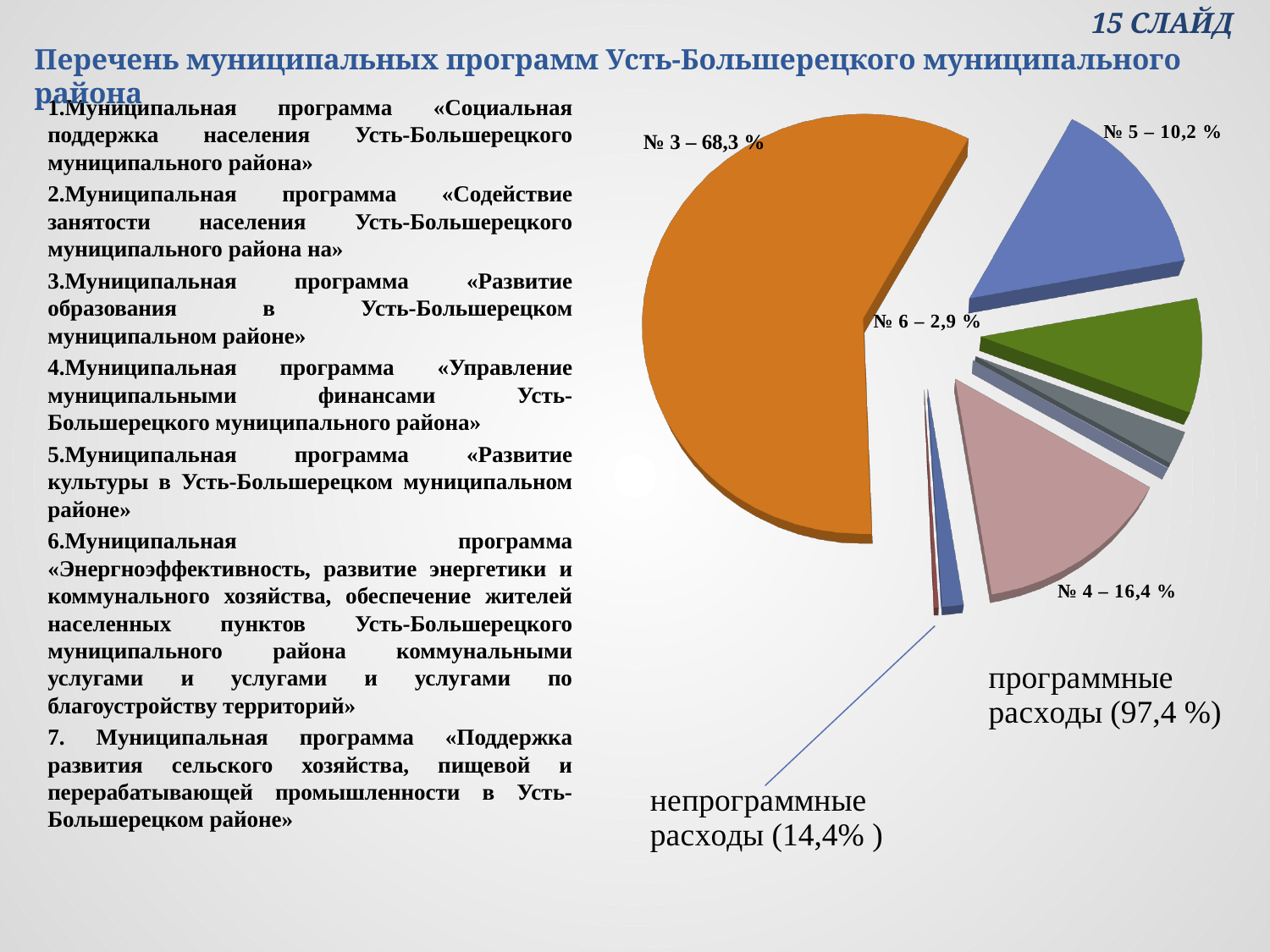
What colour is the largest slice of the pie chart? orange What share is labelled for programme № 4 in the pie chart? 16,4 % What kind of chart is shown on the slide? pie chart Which labelled programme has the smallest share in the pie chart? № 6 Which has the larger share, № 5 or № 4? № 4 What share is labelled for programme № 3 in the pie chart? 68,3 % By how many percentage points does the share of № 3 exceed the share of № 4? 51,9 % Which labelled programme has the largest share in the pie chart? № 3 What percentage is given for programme expenditures (программные расходы) next to the chart? 97,4 % What is the difference between the shares of № 4 and № 5? 6,2 % What share is labelled for programme № 6 in the pie chart? 2,9 % What share is labelled for programme № 5 in the pie chart? 10,2 %